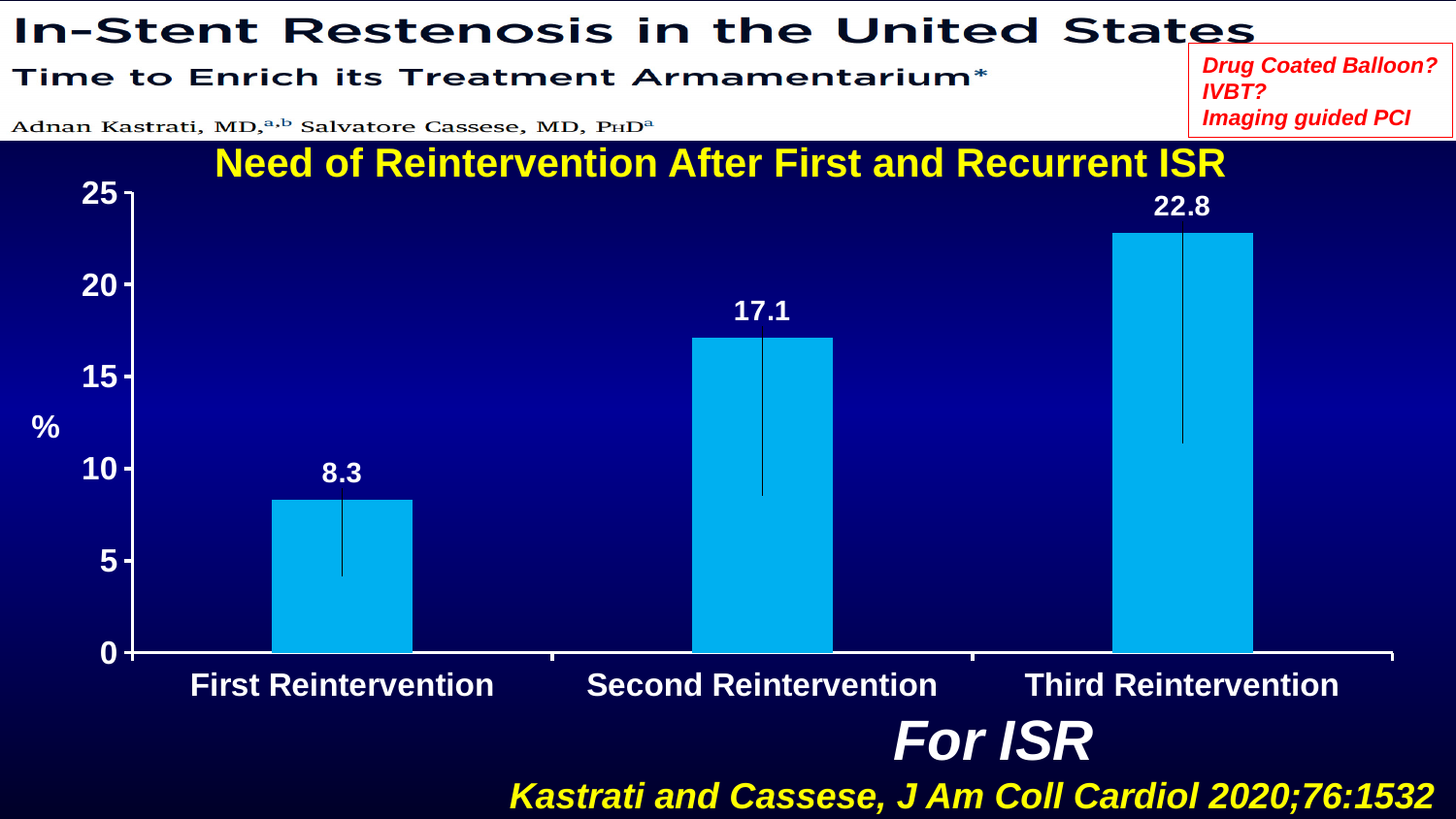
What is the value for Second Reintervention? 17.1 What is the value for First Reintervention? 8.3 Is the value for Second Reintervention greater or less than 15? greater What is the difference between the values for Third Reintervention and First Reintervention? 14.5 Which is larger, the value for Second Reintervention or the value for Third Reintervention? Third Reintervention Which category has the highest value? Third Reintervention Which category has the lowest value? First Reintervention What is the value for Third Reintervention? 22.8 What kind of chart is shown on the slide? bar chart What is the difference between the values for Second Reintervention and First Reintervention? 8.8 Do the values rise or fall from First Reintervention to Third Reintervention? rise How many categories are shown on the x axis? 3